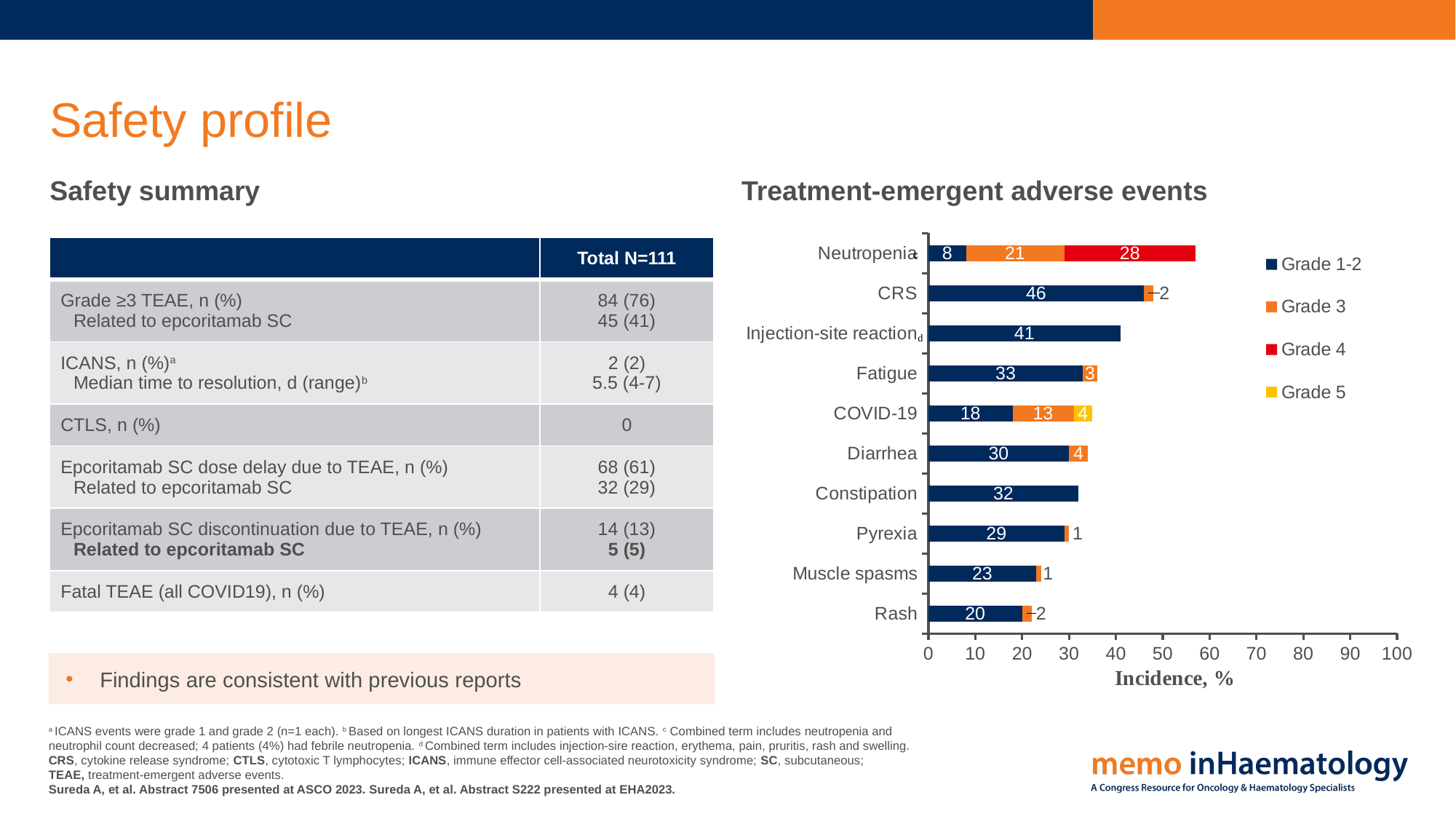
What is the Grade 5 incidence for COVID-19? 4 What is the Grade 1-2 incidence for CRS? 46 What is the total incidence (all grades) for Neutropenia? 57 What is the total incidence (all grades) for COVID-19? 35 What is the difference between the Grade 1-2 incidence for Injection-site reaction and for Fatigue? 8 Which adverse event has the highest total incidence? Neutropenia How many series does the chart legend list? 4 Which is larger: the Grade 1-2 incidence for Constipation or for Pyrexia? Constipation Which adverse event has the lowest total incidence? Rash How many adverse event categories are plotted in the chart? 10 What is the Grade 4 incidence for Neutropenia? 28 What type of chart is shown under "Treatment-emergent adverse events"? Stacked bar chart